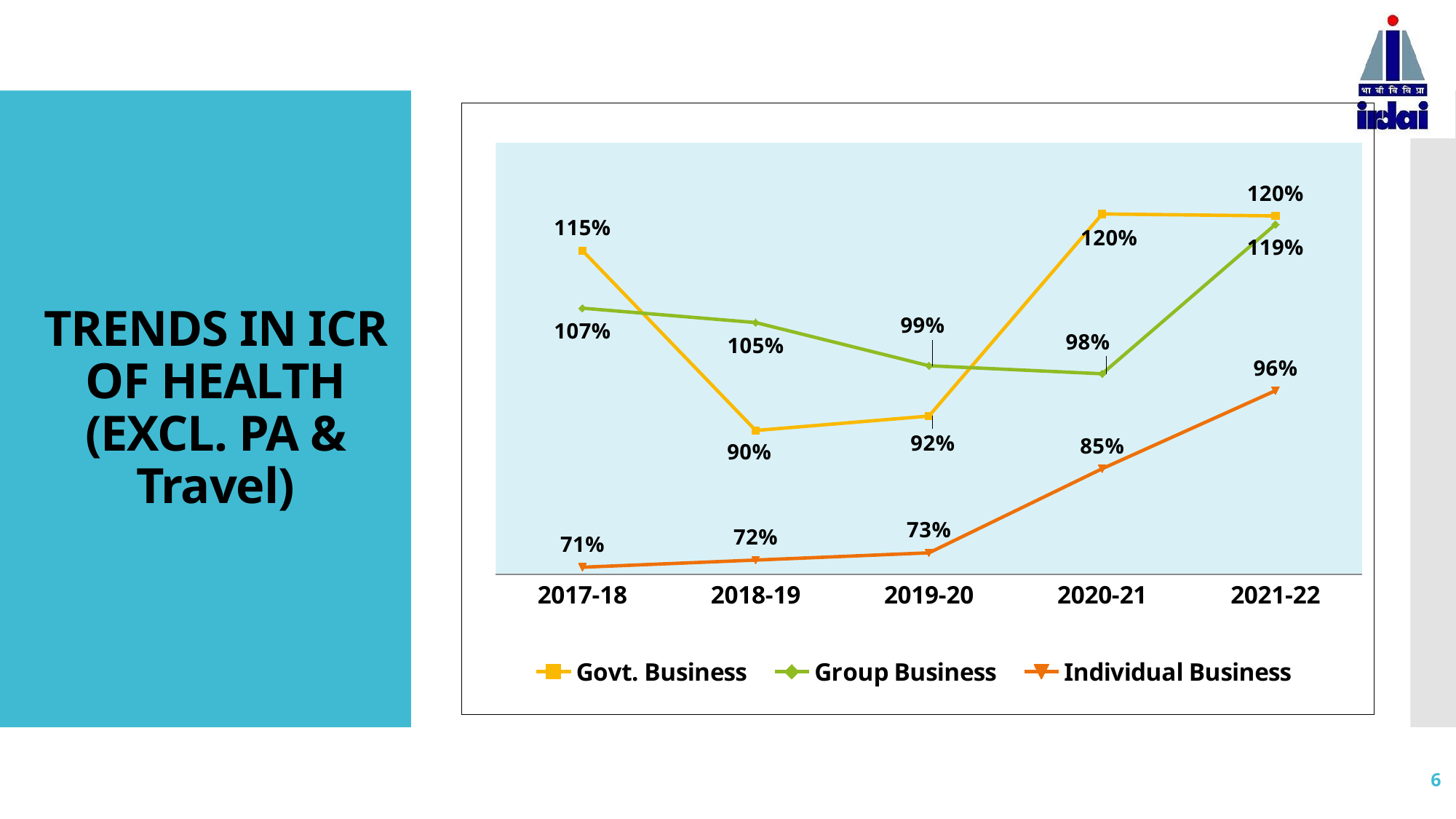
What is the difference between Govt. Business and Individual Business in 2020-21? 35% What is the value for Group Business in 2019-20? 99% In which year is Govt. Business at its lowest? 2018-19 In which year is Individual Business at its highest? 2021-22 Which series is drawn in green? Group Business What is the value for Govt. Business in 2017-18? 115% How many series does the legend list? 3 Which is larger in 2018-19, Govt. Business or Group Business? Group Business What is the value for Individual Business in 2021-22? 96% What kind of chart is shown on the slide? Line chart Does the Individual Business line rise or fall from 2017-18 to 2021-22? Rise How many years are shown on the x axis? 5